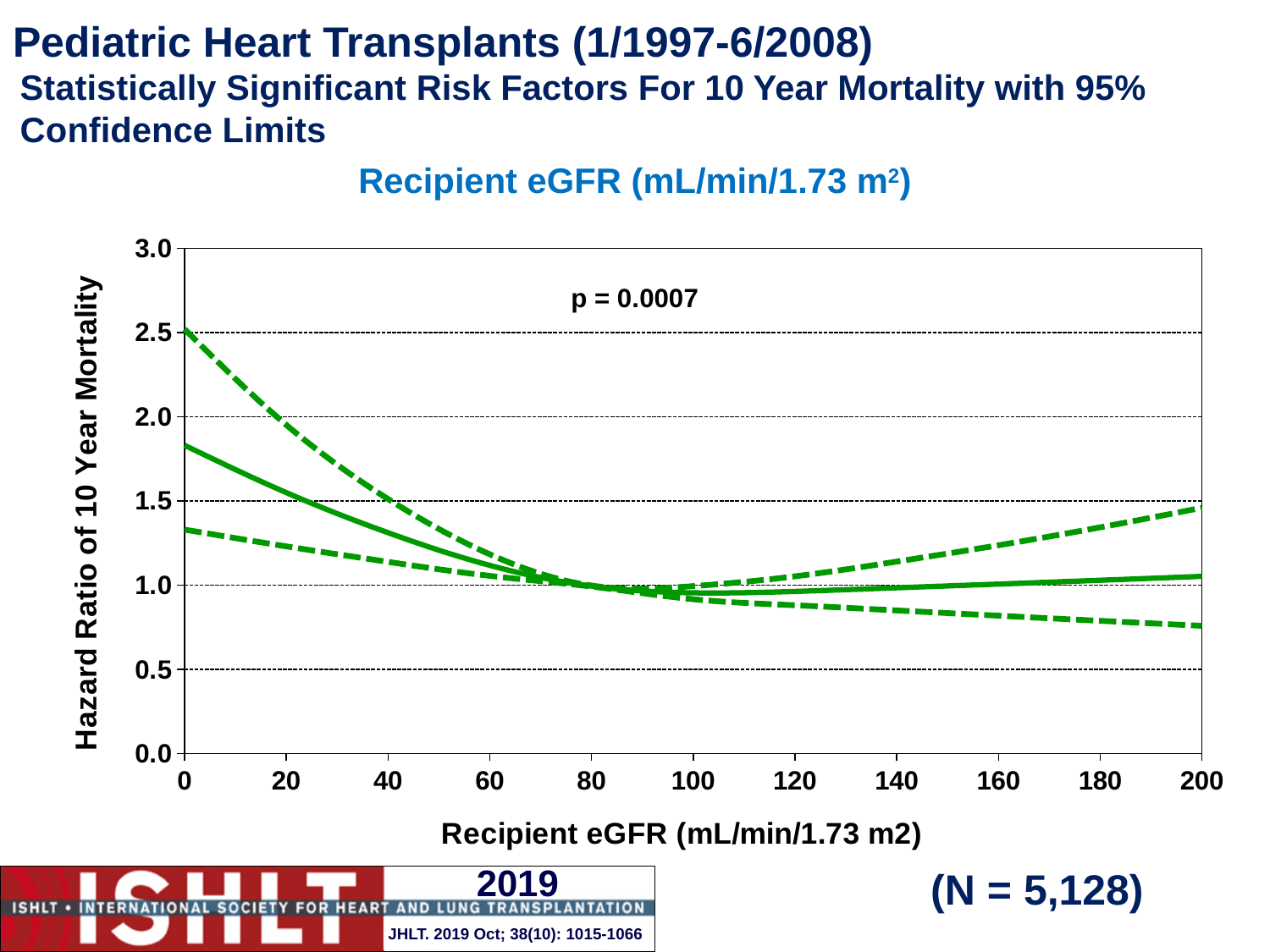
What is the highest value labelled on the y axis? 3.0 Is the lower confidence limit (lower dashed line) at a recipient eGFR of 200 greater or less than 1.0? less How many lines are plotted on the chart? 3 What is the sample size (N) shown on the slide? 5,128 Is the upper confidence limit (upper dashed line) at a recipient eGFR of 200 greater or less than 1.0? greater What is the p-value printed on the chart? p = 0.0007 Is the hazard ratio (solid line) at a recipient eGFR of 0 greater or less than 1.5? greater What kind of chart is shown on the slide? line chart Does the hazard ratio (solid line) rise or fall as recipient eGFR increases from 0 to 60? fall